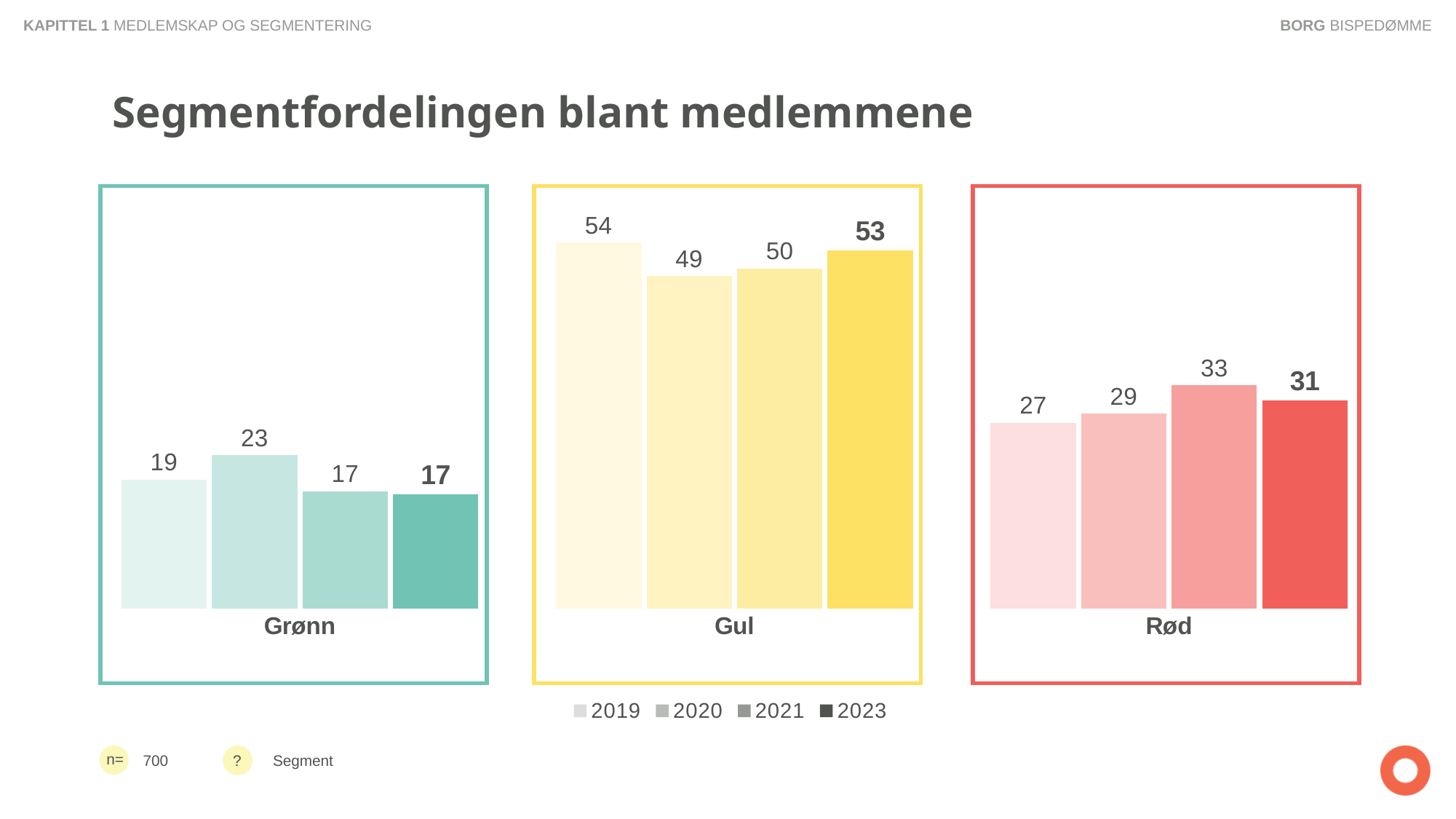
What is the value for Grønn in 2020? 23 Which segment has the lowest value in 2021? Grønn Which segment has the highest value in 2023? Gul Do the values for Rød rise or fall from 2019 to 2021? Rise Which is larger for Rød: the 2021 value or the 2023 value? 2021 What is the difference between the Gul value in 2019 and the Gul value in 2020? 5 What kind of chart is shown on the slide? Bar chart How many series does the legend list? 4 What is the title of the slide's chart? Segmentfordelingen blant medlemmene What is the value for Gul in 2023? 53 What is the value for Rød in 2019? 27 How many segments (categories) are shown on the chart? 3